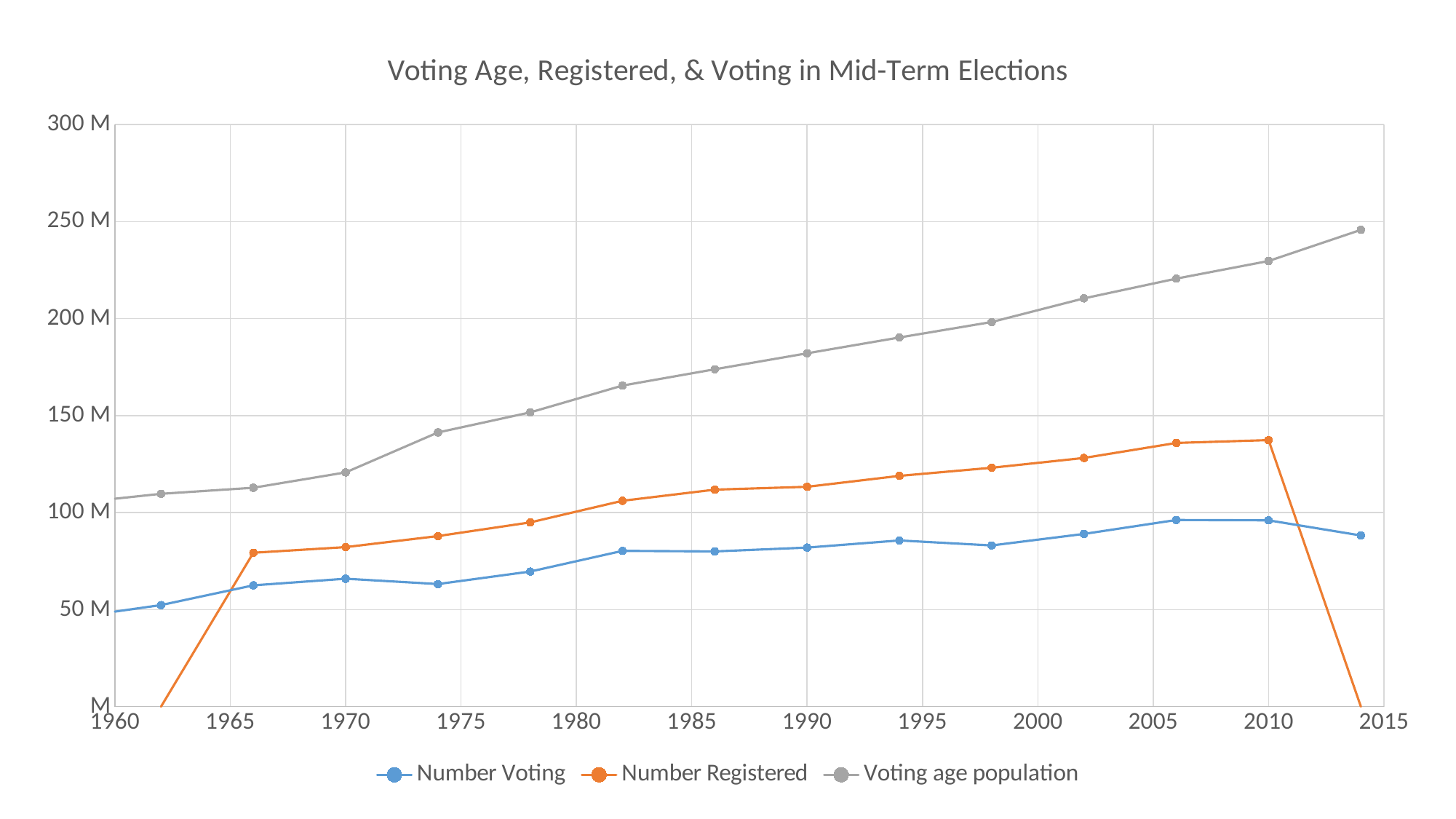
What kind of chart is shown on the slide? Line chart What is the title of the chart? Voting Age, Registered, & Voting in Mid-Term Elections Which colour is used for the Number Registered series? Orange Is the Number Voting value for 2006 greater or less than 100 M? less How many series does the legend list? 3 Is the Number Registered value for 1966 greater or less than 100 M? less Does the Voting age population series rise or fall from 1962 to 2014? Rise Is the Voting age population value for 2014 greater or less than 200 M? greater For the Number Voting series, which is larger: the value for 2006 or the value for 2014? 2006 In 2010, which is larger: Voting age population or Number Registered? Voting age population